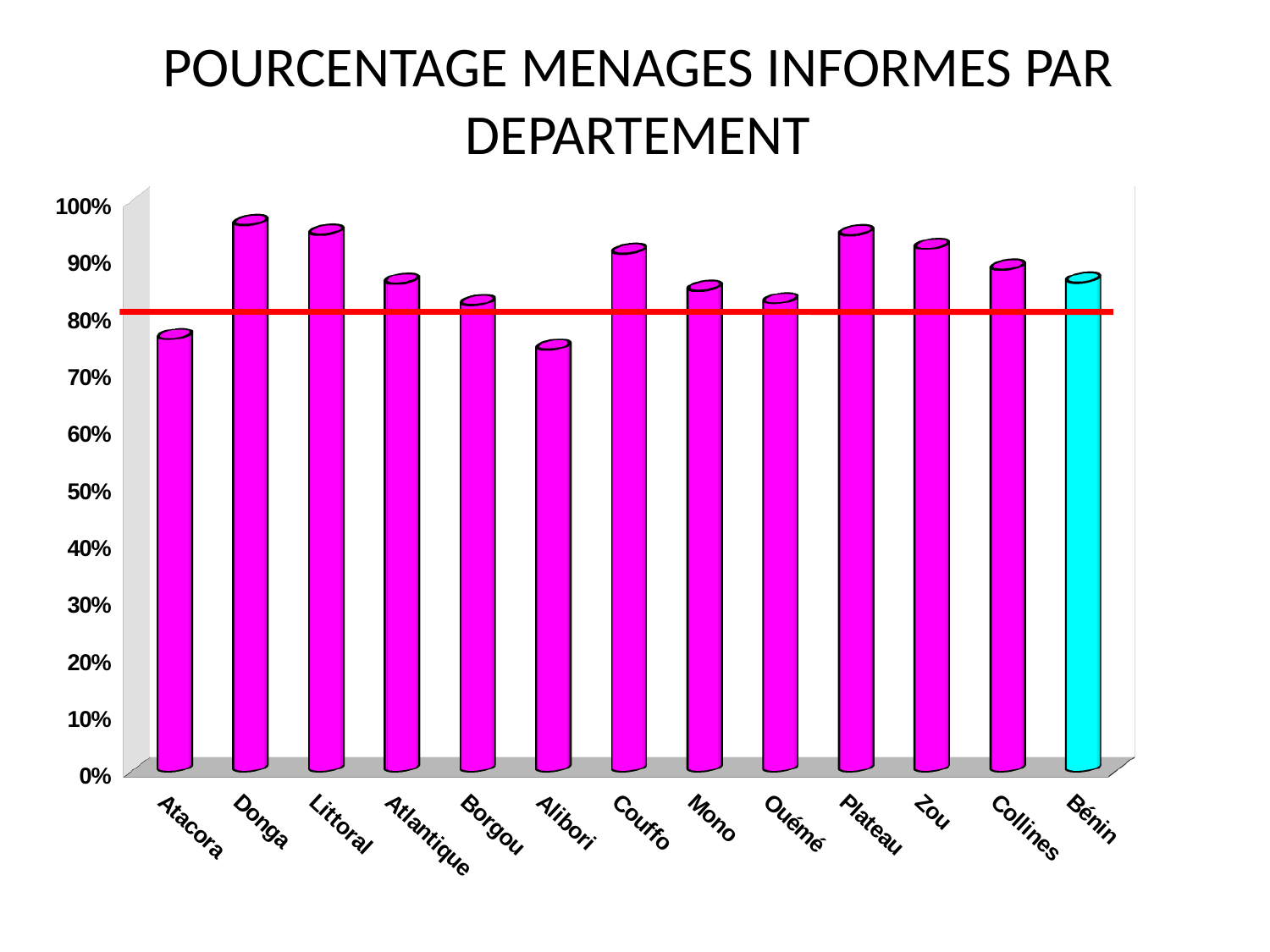
Is the value for Alibori greater or less than 80%? less Is the value for Donga greater or less than 90%? greater What kind of chart is shown on the slide? bar chart Which is larger, the value for Alibori or the value for Couffo? Couffo Which bar in the chart is drawn in a different colour (cyan) from the others? Bénin How many categories are shown on the x axis of the chart? 13 Which is larger, the value for Donga or the value for Atacora? Donga Which category has the highest bar in the chart? Donga Is the value for Atacora greater or less than 80%? less Which category has the lowest bar in the chart? Alibori